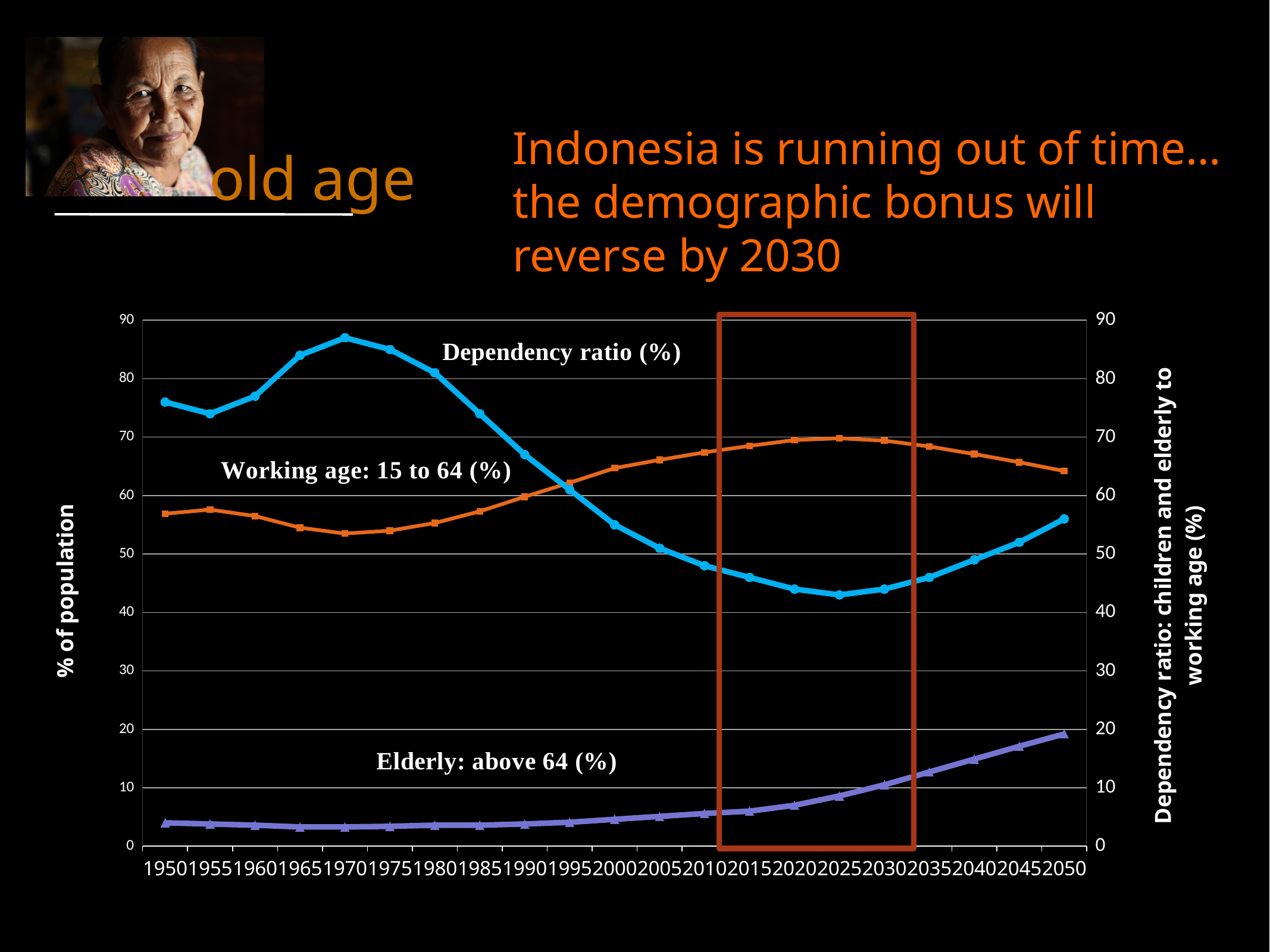
In which year is the Elderly: above 64 (%) line at its highest? 2050 Is the Working age: 15 to 64 (%) value for 2025 greater or less than 60? greater Is the Dependency ratio (%) value for 2025 greater or less than 50? less Does the Elderly: above 64 (%) line rise or fall between 2010 and 2050? Rise What is the title of the left vertical axis? % of population How many years are plotted along the x axis of the chart? 21 In 1950, which is larger: the Dependency ratio (%) or the Working age: 15 to 64 (%)? Dependency ratio (%) How many series are plotted on the chart? 3 In which year does the Dependency ratio (%) line reach its highest value? 1970 Is the Dependency ratio (%) value for 1970 greater or less than 80? greater In which year does the Dependency ratio (%) line reach its lowest value? 2025 What kind of chart is shown on the slide? Line chart